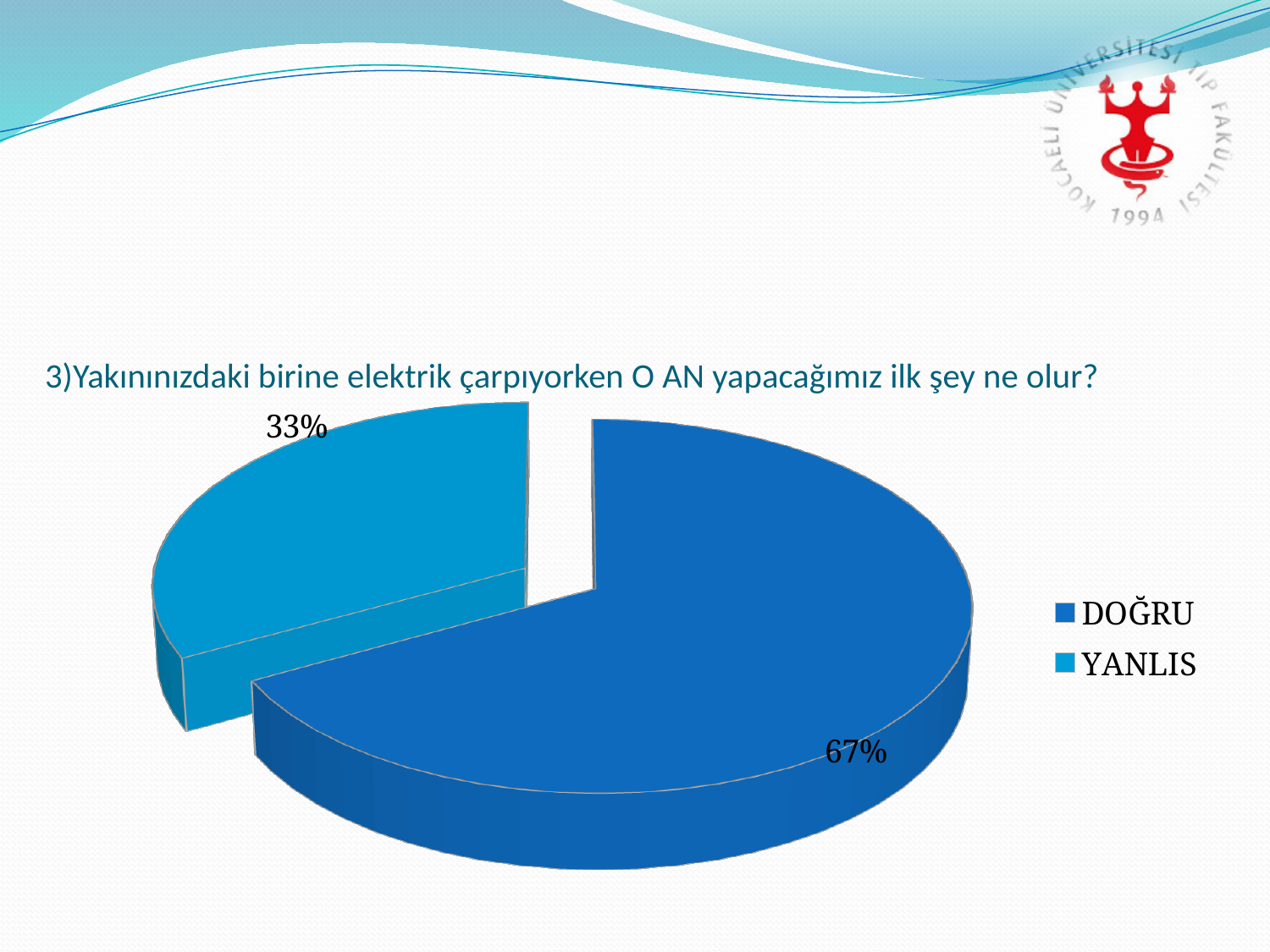
What share of the pie does the YANLIS slice represent? 33% What is the difference in percentage points between the DOĞRU and YANLIS slices? 34 What percentage of the pie is labelled DOĞRU? 67% What kind of chart is shown on the slide? pie chart How many slices does the pie chart have? 2 How many entries does the legend list? 2 Which legend entry is shown in the lighter blue colour? YANLIS Which slice of the pie is the largest? DOĞRU Which slice of the pie is the smallest? YANLIS What question is written above the pie chart? 3)Yakınınızdaki birine elektrik çarpıyorken O AN yapacağımız ilk şey ne olur? Which is larger, the DOĞRU slice or the YANLIS slice? DOĞRU What percentage of the pie is labelled YANLIS? 33%